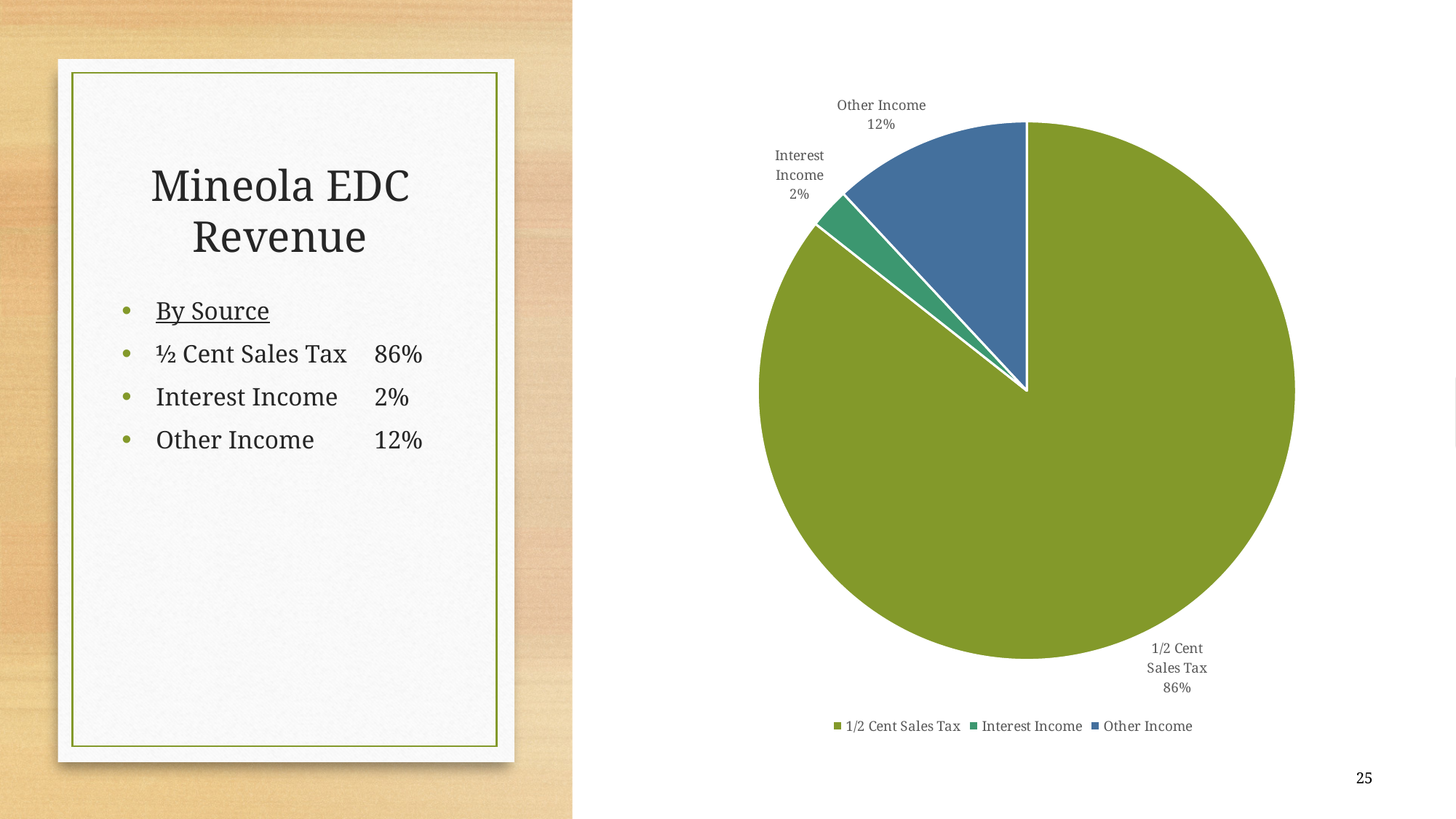
How many slices does the pie chart have? 3 Which slice of the pie is the largest? 1/2 Cent Sales Tax What kind of chart is shown on the slide? pie chart How many entries does the legend list? 3 Which slice of the pie is the smallest? Interest Income What is the difference in percentage points between Other Income and Interest Income? 10 What colour is the 1/2 Cent Sales Tax slice? green What colour is the Other Income slice? blue What share of the pie does Interest Income represent? 2% Which is larger, Other Income or Interest Income? Other Income What share of the pie does Other Income represent? 12% What share of the pie does 1/2 Cent Sales Tax represent? 86%